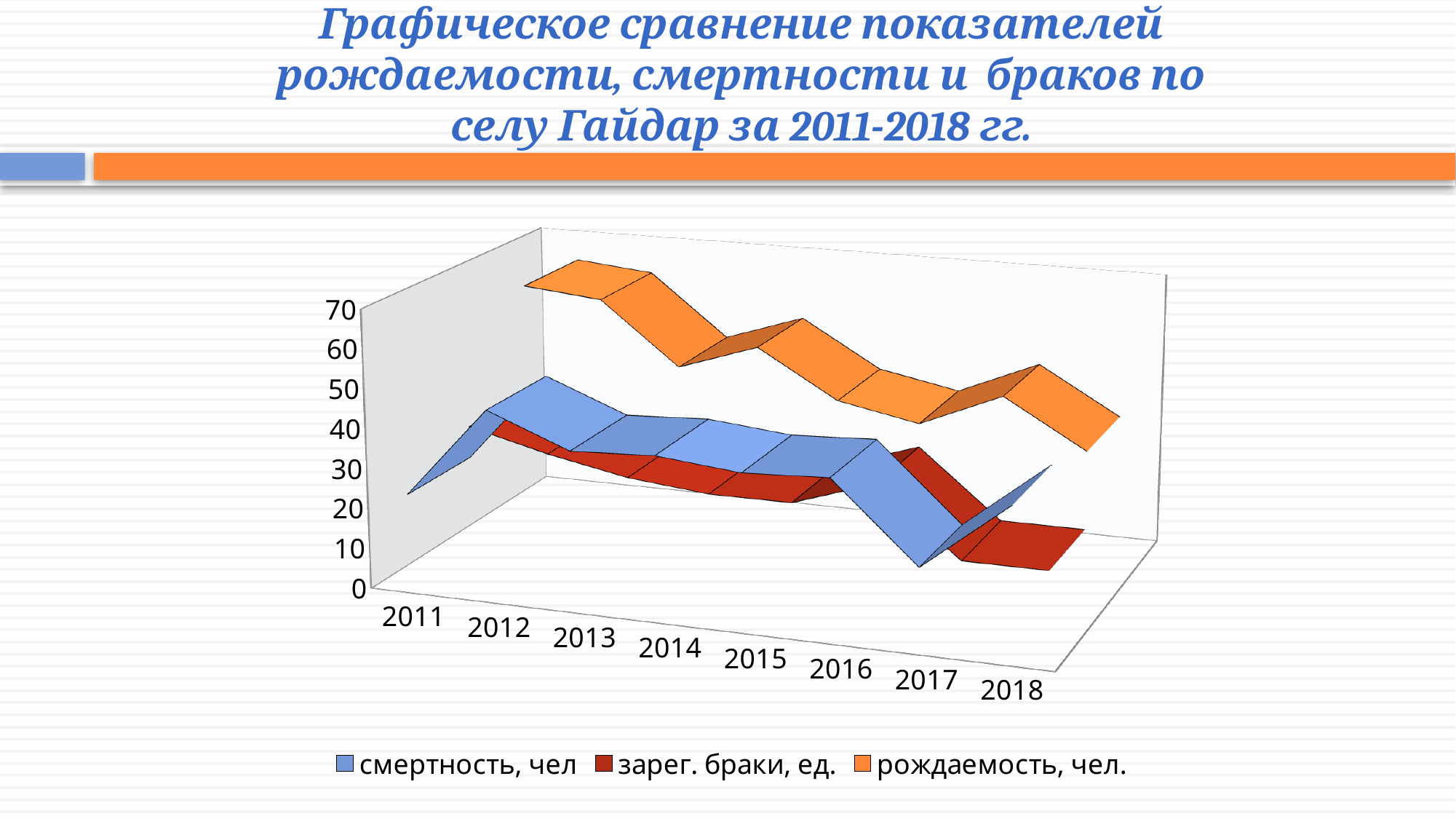
Does the рождаемость series rise or fall overall from 2011 to 2018? fall Which series is shown in dark red? зарег. браки, ед. What is the first year shown on the x axis? 2011 Which series is shown in orange? рождаемость, чел. What kind of chart is shown on the slide? line chart In which year is смертность lowest? 2017 Is the value for рождаемость in 2011 greater or less than 20? greater In 2011, which is larger: рождаемость or смертность? рождаемость How many series does the legend list? 3 How many years are shown on the x axis? 8